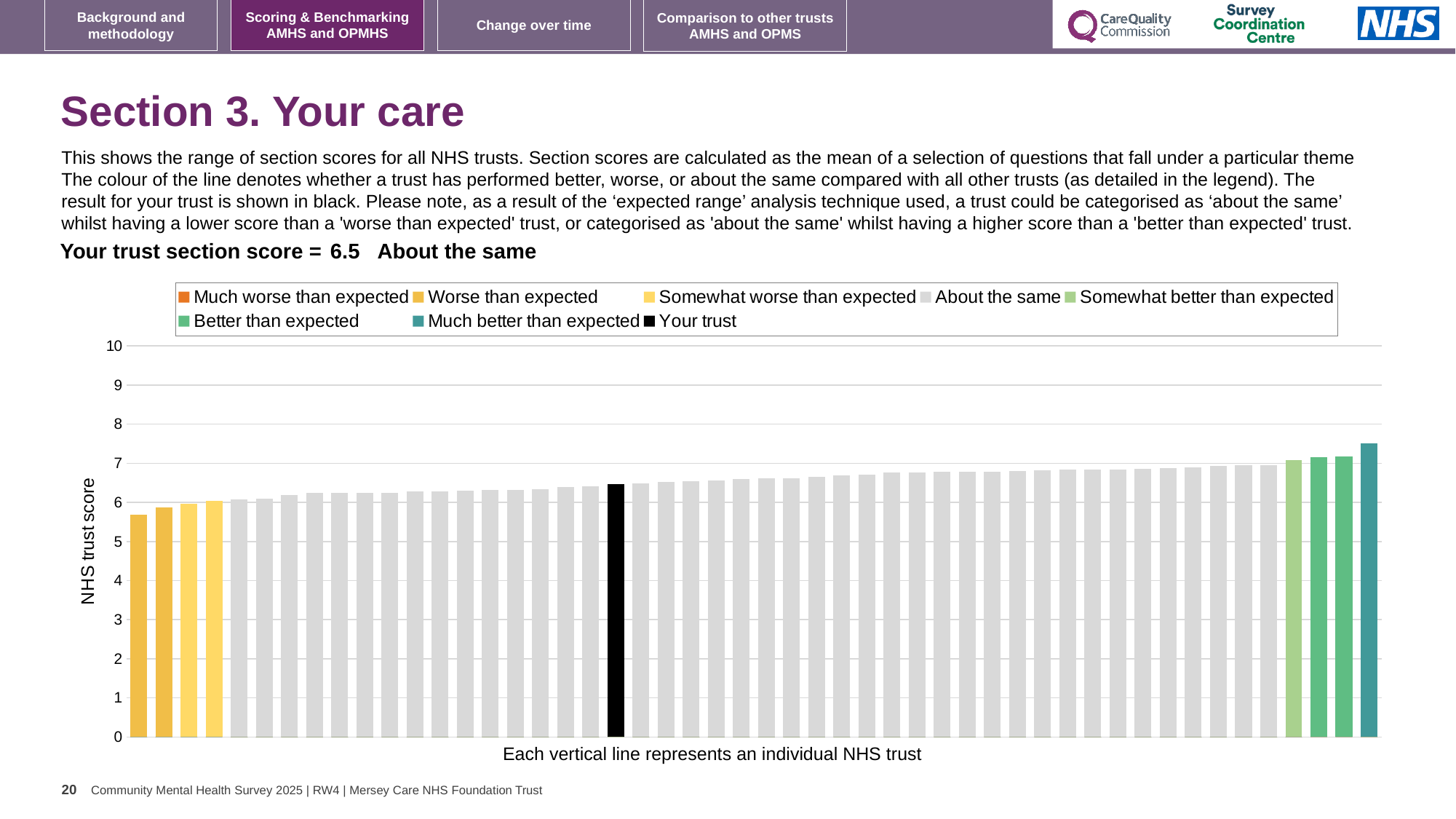
What kind of chart is shown on the slide? bar chart Is the value for your trust (the black bar) greater or less than 6? greater How many entries does the chart legend list? 8 Which category is your trust placed in for this section? About the same What is the label on the vertical axis of the chart? NHS trust score Is the value for the tallest bar (Much better than expected) greater or less than 7? greater What is the highest value shown on the vertical axis? 10 What is the section score for your trust shown on the slide? 6.5 Do the bar values rise or fall from left to right along the x axis? rise How many bars are coloured as 'Much better than expected'? 1 Which is larger, the value for your trust (black bar) or the value for the leftmost bar? your trust Is the value for the leftmost bar greater or less than 6? less